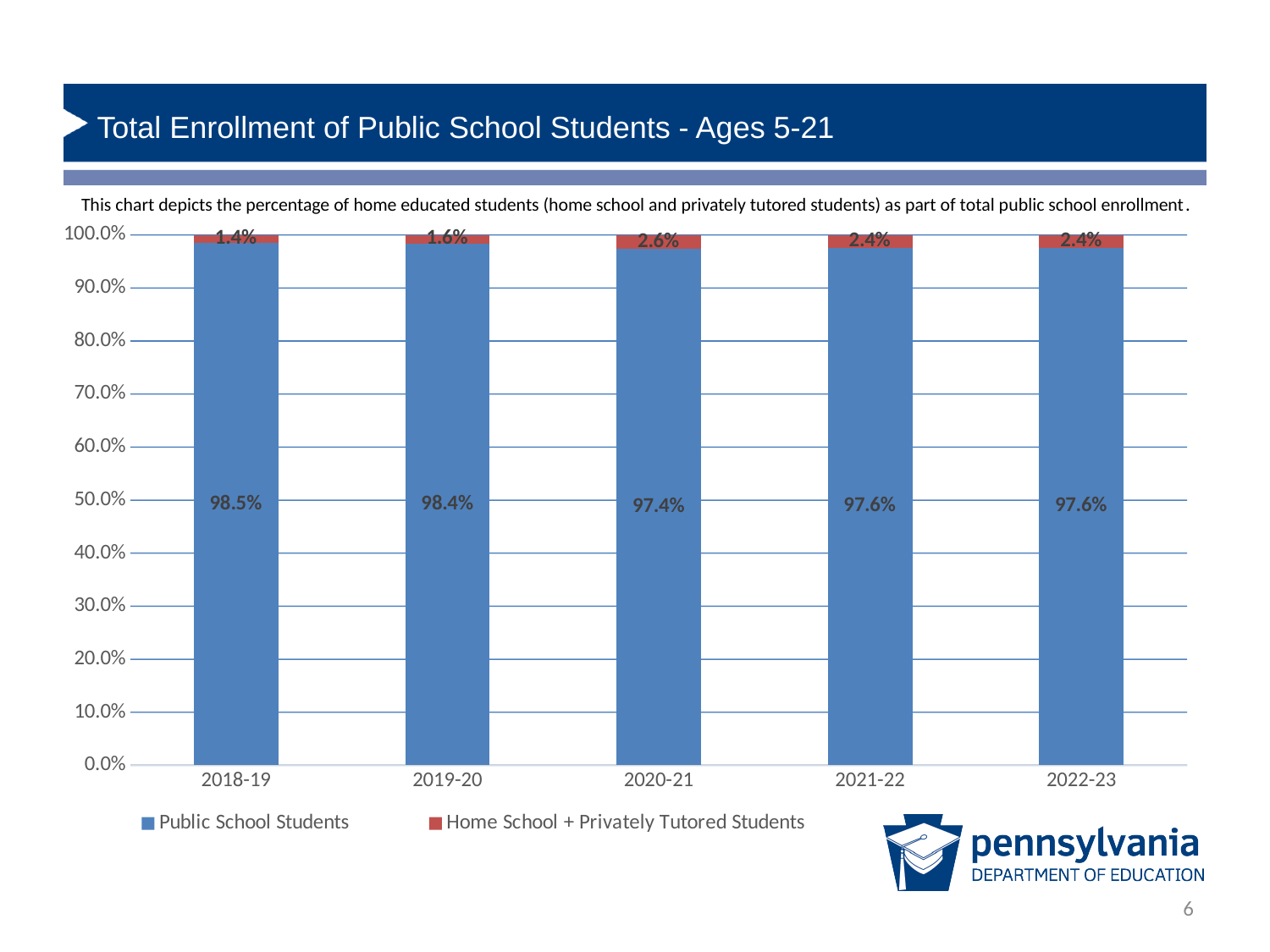
What is the value for Home School + Privately Tutored Students in 2022-23? 2.4% How many school years are shown on the x axis? 5 What percentage of total enrollment were Public School Students in 2018-19? 98.5% Which year had a larger share of Home School + Privately Tutored Students, 2018-19 or 2019-20? 2019-20 What is the value for Public School Students in 2019-20? 98.4% In which school year was the share of Home School + Privately Tutored Students highest? 2020-21 In which school year was the share of Public School Students lowest? 2020-21 What percentage of total enrollment were Home School + Privately Tutored Students in 2020-21? 2.6% How many series does the legend list? 2 In which school year was the share of Home School + Privately Tutored Students lowest? 2018-19 What kind of chart is shown on the slide? Stacked bar chart By how many percentage points did the Home School + Privately Tutored share in 2020-21 exceed that in 2018-19? 1.2 percentage points